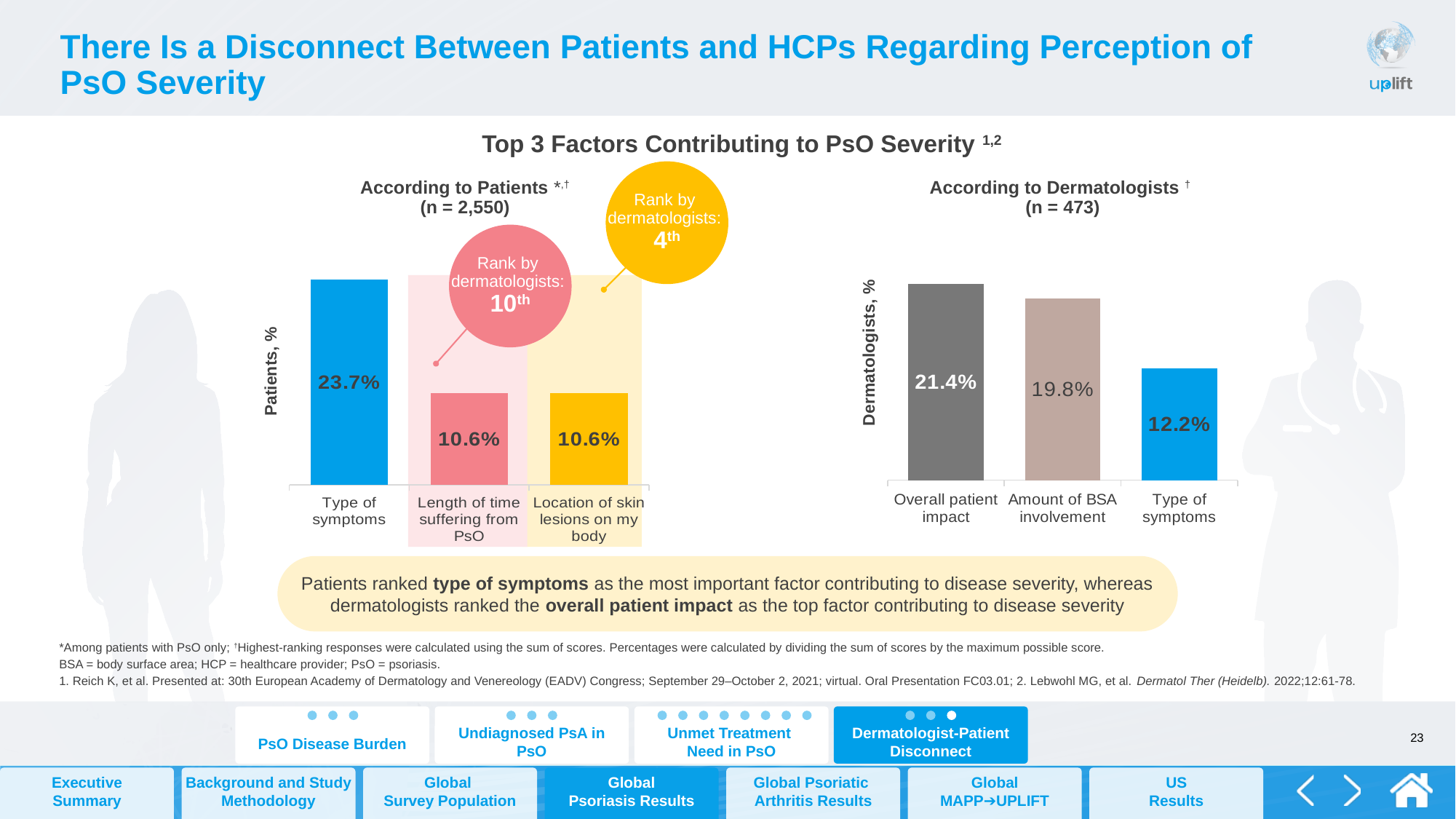
In the 'According to Dermatologists' chart, which is larger: Overall patient impact or Amount of BSA involvement? Overall patient impact In the 'According to Dermatologists' chart, what is the difference between Overall patient impact and Type of symptoms? 9.2% In the 'According to Patients' chart, which category has the highest value? Type of symptoms In the 'According to Patients' chart, what is the value for Type of symptoms? 23.7% How many categories are shown in the 'According to Patients' chart? 3 In the 'According to Patients' chart, what is the value for Length of time suffering from PsO? 10.6% In the 'According to Dermatologists' chart, what is the value for Type of symptoms? 12.2% In the 'According to Dermatologists' chart, what is the value for Amount of BSA involvement? 19.8% What type of chart is the 'According to Dermatologists' chart? Bar chart In the 'According to Patients' chart, what is the difference between Type of symptoms and Location of skin lesions on my body? 13.1% In the 'According to Dermatologists' chart, which category has the lowest value? Type of symptoms In the 'According to Dermatologists' chart, what is the value for Overall patient impact? 21.4%